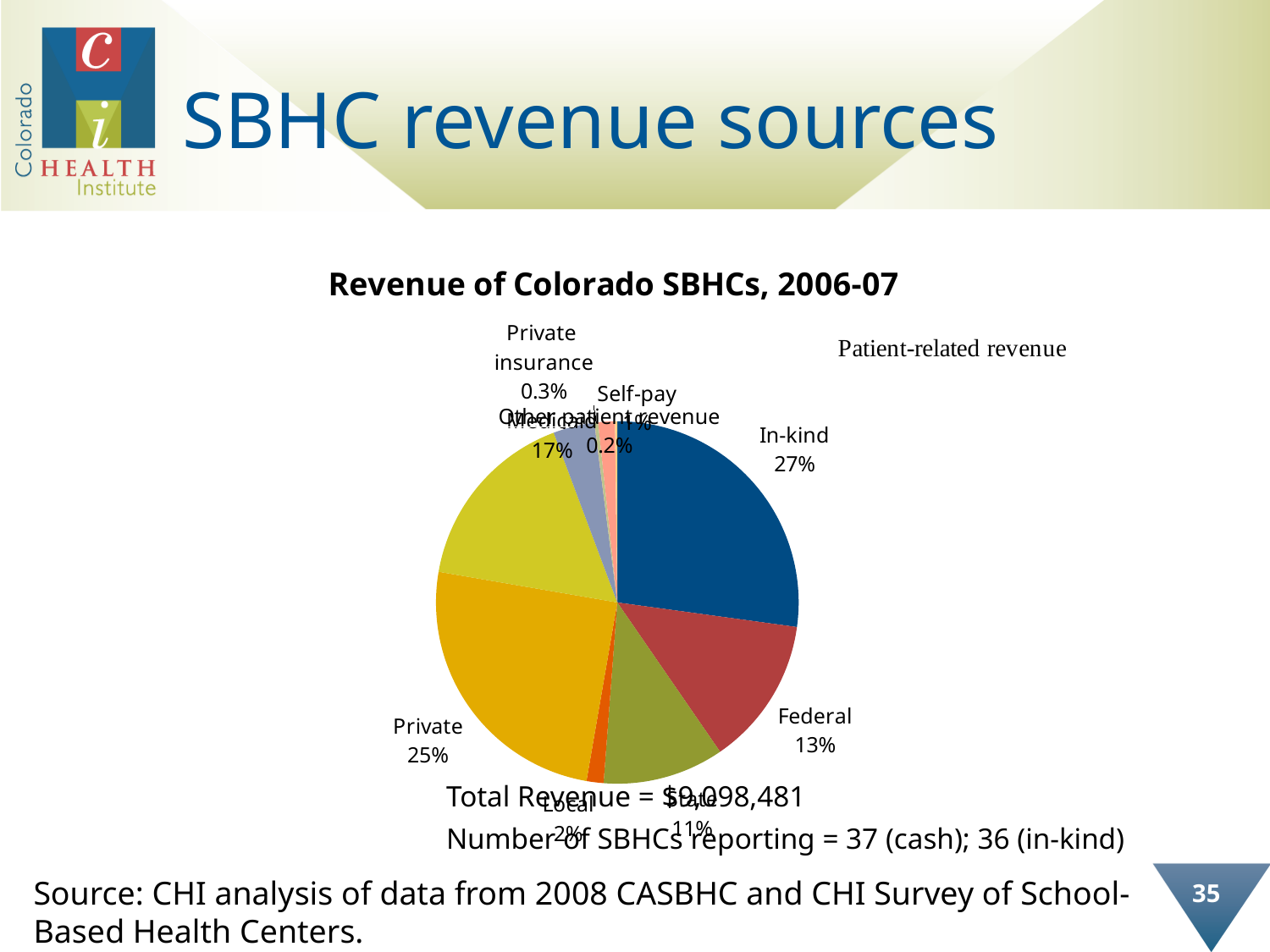
What type of chart is shown on the slide? pie chart What percentage of revenue is Federal? 13% What total revenue is stated below the chart? $9,098,481 What is the title of the chart? Revenue of Colorado SBHCs, 2006-07 What percentage of revenue comes from Medicaid? 17% What percentage of revenue comes from Private insurance? 0.3% What percentage of revenue is Private? 25% What share of revenue comes from In-kind sources? 27% What is the difference in percentage points between the In-kind and Private shares? 2 Which is larger, the Federal share or the Medicaid share? Medicaid Which revenue source has the largest share of the pie? In-kind